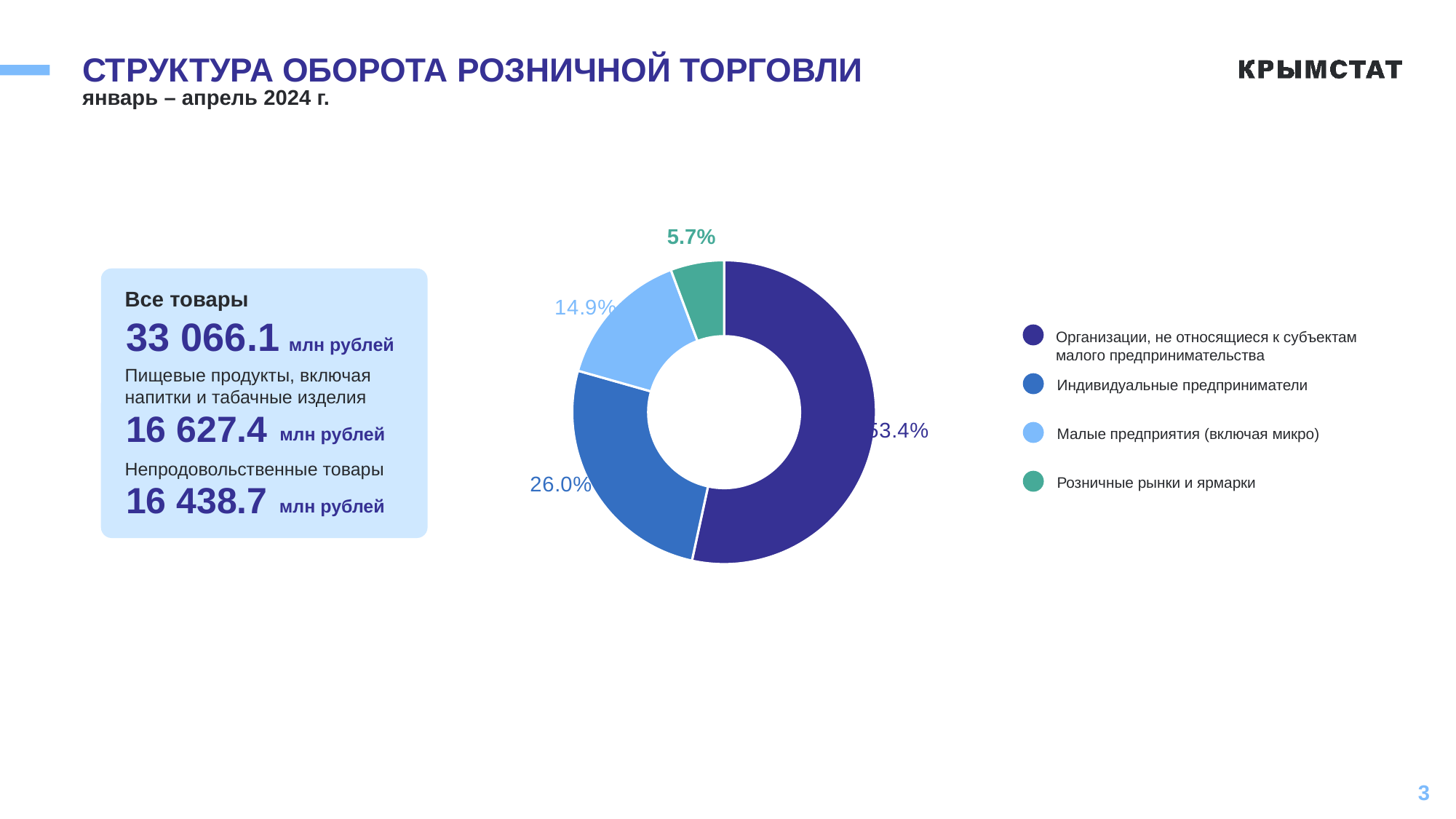
What share of retail trade turnover is attributed to 'Индивидуальные предприниматели'? 26.0% What type of chart is shown on the slide? Donut (pie) chart How many categories does the legend of the donut chart list? 4 Which category has the largest share in the donut chart? Организации, не относящиеся к субъектам малого предпринимательства What colour is the slice for 'Розничные рынки и ярмарки' in the donut chart? Green (teal) What is the difference in percentage points between the shares of 'Малые предприятия (включая микро)' and 'Розничные рынки и ярмарки'? 9.2 percentage points What share of retail trade turnover is attributed to 'Организации, не относящиеся к субъектам малого предпринимательства'? 53.4% What share of retail trade turnover is attributed to 'Розничные рынки и ярмарки'? 5.7% Which share is larger: 'Индивидуальные предприниматели' or 'Малые предприятия (включая микро)'? Индивидуальные предприниматели What is the difference in percentage points between the shares of 'Индивидуальные предприниматели' and 'Малые предприятия (включая микро)'? 11.1 percentage points Which category has the smallest share in the donut chart? Розничные рынки и ярмарки What share of retail trade turnover is attributed to 'Малые предприятия (включая микро)'? 14.9%